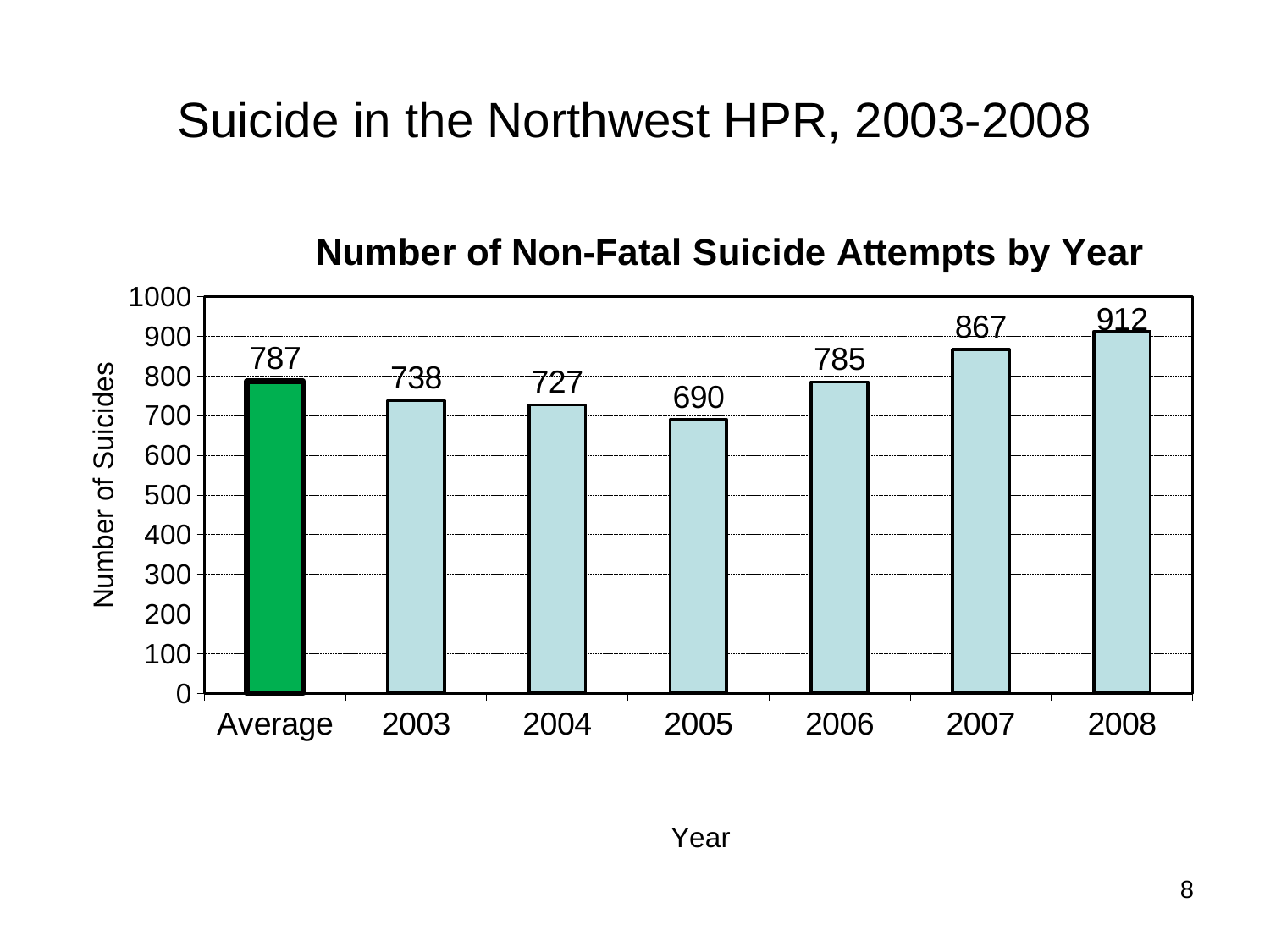
What is the difference between the values for 2008 and 2007? 45 Is the value for 2007 greater or less than 800? greater What kind of chart is shown on the slide? Bar chart What is the number of non-fatal suicide attempts in 2005? 690 Which year has the highest number of non-fatal suicide attempts? 2008 What is the number of non-fatal suicide attempts in 2008? 912 What is the value shown for the Average bar? 787 What is the title of the chart? Number of Non-Fatal Suicide Attempts by Year Which year has the lowest number of non-fatal suicide attempts? 2005 Which is larger, the value for 2006 or the value for 2003? 2006 How many bars are shown in the chart? 7 What is the difference between the values for 2003 and 2004? 11